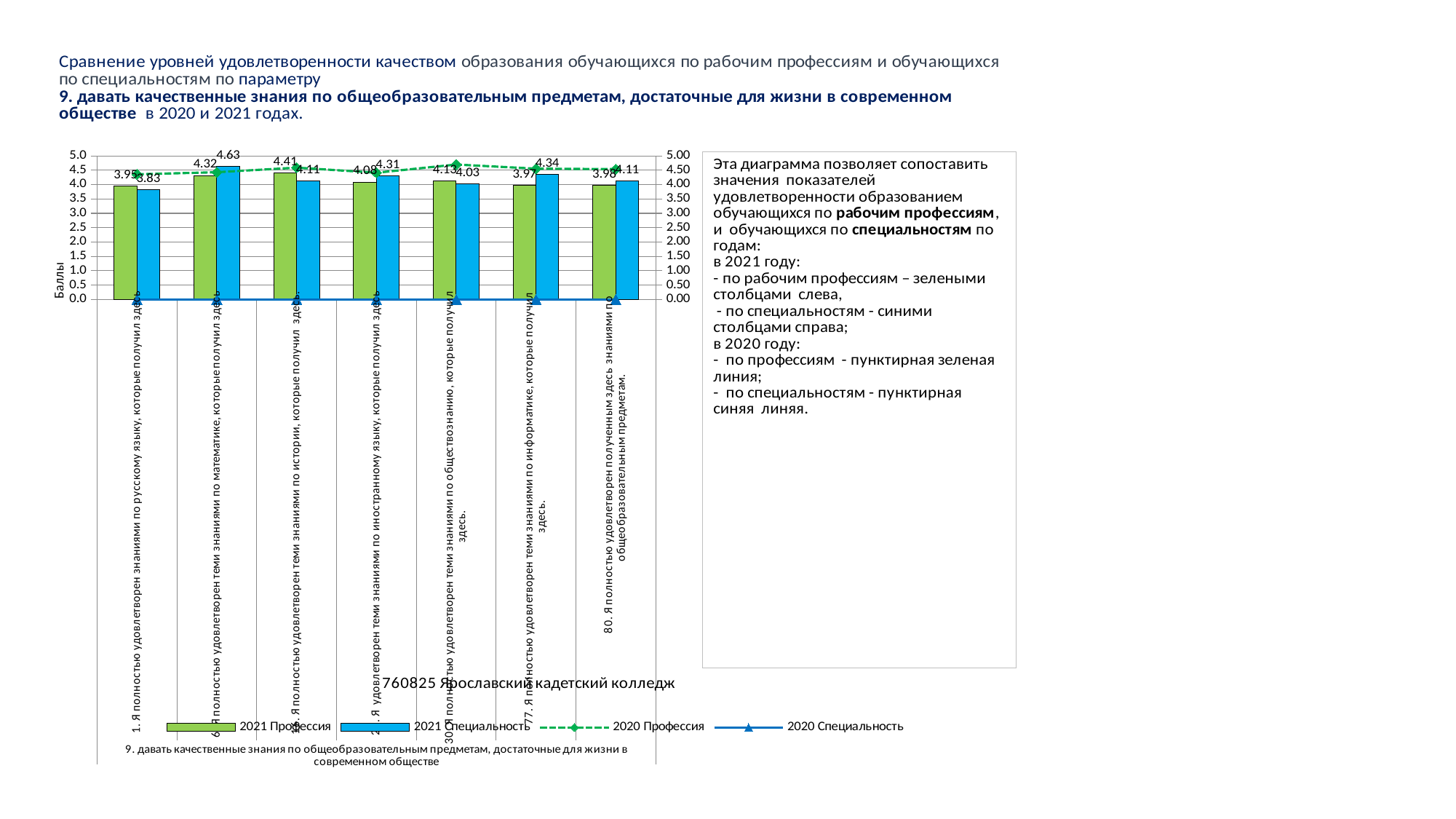
How many categories are shown on the x axis of the chart? 7 What is the value of the 2021 Профессия bar for the category about русский язык (1. Я полностью удовлетворен знаниями по русскому языку...)? 3.95 What is the difference between the 2021 Специальность and 2021 Профессия values for the математика category? 0.31 What is the value of the 2021 Специальность bar for the category about математика? 4.63 Which category has the highest 2021 Профессия value? история (Я полностью удовлетворен теми знаниями по истории, которые получил здесь) Which category has the highest 2021 Специальность value? математика (6. Я полностью удовлетворен теми знаниями по математике, которые получил здесь) Is the 2020 Профессия value for the русский язык category greater or less than 4.0? greater What is the value of the 2021 Профессия bar for the category about математика (6. Я полностью удовлетворен теми знаниями по математике...)? 4.32 For the информатика category (77.), which is larger: the 2021 Профессия value or the 2021 Специальность value? 2021 Специальность What are the four series names listed in the chart legend? 2021 Профессия, 2021 Специальность, 2020 Профессия, 2020 Специальность Which category has the lowest 2021 Специальность value? русский язык (1. Я полностью удовлетворен знаниями по русскому языку, которые получил здесь) How many series does the chart legend list? 4